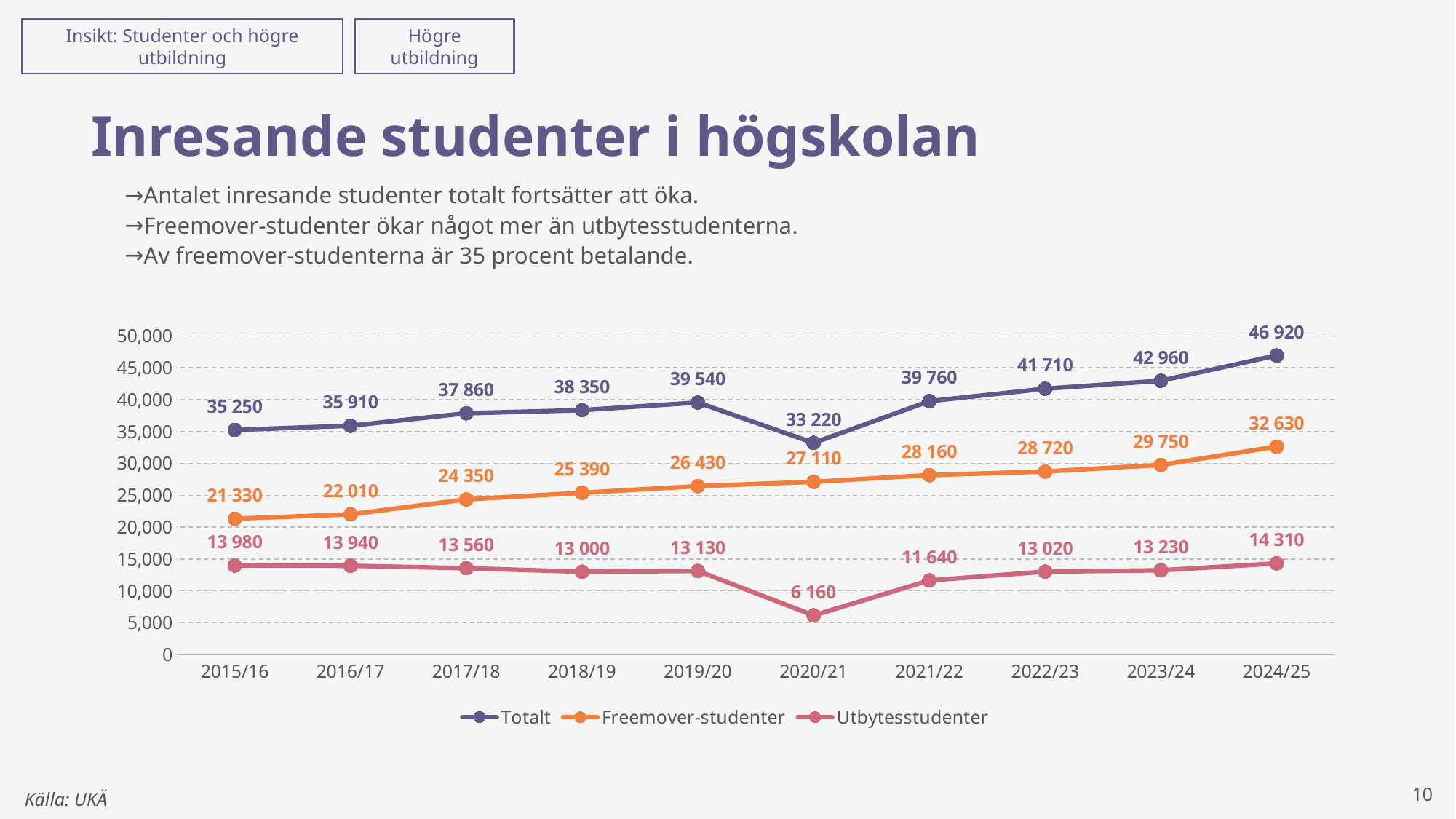
What kind of chart is shown on the slide? Line chart Does the Freemover-studenter series rise or fall from 2015/16 to 2024/25? Rise How many academic years are shown on the x axis? 10 Which is larger in 2021/22: Freemover-studenter or Utbytesstudenter? Freemover-studenter By how much did Freemover-studenter increase from 2015/16 to 2024/25? 11 300 What is the value for Freemover-studenter in 2017/18? 24 350 What is the value for Utbytesstudenter in 2020/21? 6 160 What is the value for Totalt in 2024/25? 46 920 In which year is the Utbytesstudenter series at its highest? 2024/25 In which year is the Totalt series at its lowest? 2020/21 What is the difference between the Totalt values for 2024/25 and 2023/24? 3 960 How many series does the legend list? 3